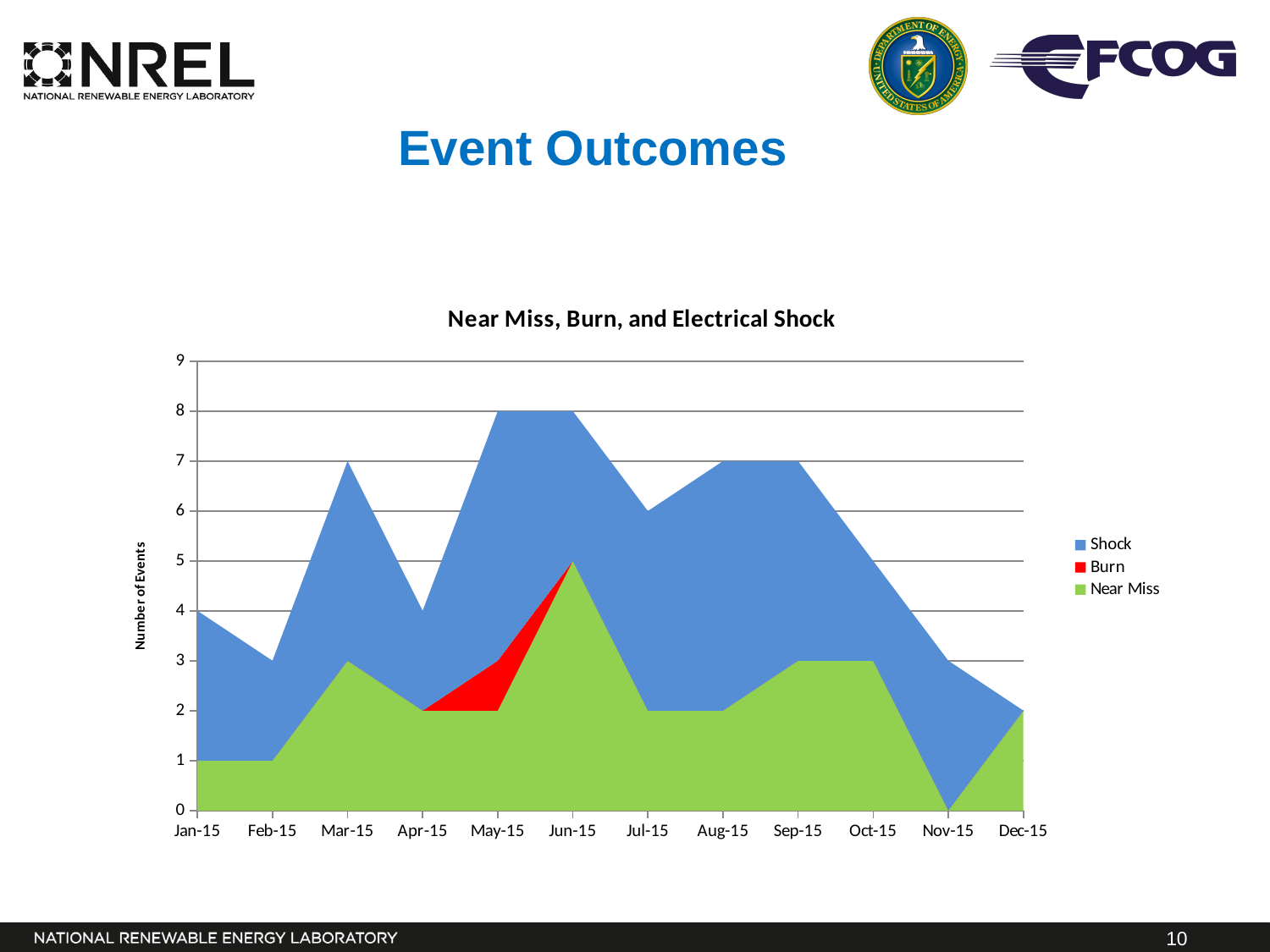
What kind of chart is shown on the slide? Stacked area chart What is the label on the vertical axis? Number of Events How many series does the legend list? 3 What is the title of the chart? Near Miss, Burn, and Electrical Shock Which is larger, the total number of events in Mar-15 or in Apr-15? Mar-15 What is the total number of events in Dec-15? 2 In which month is the Near Miss value highest? Jun-15 What is the total number of events in Mar-15 (top of the stacked area)? 7 Is the total number of events in May-15 greater or less than 7? greater How many months are shown along the x axis? 12 What is the Near Miss value in Jun-15? 5 In which month is the total number of events lowest? Dec-15